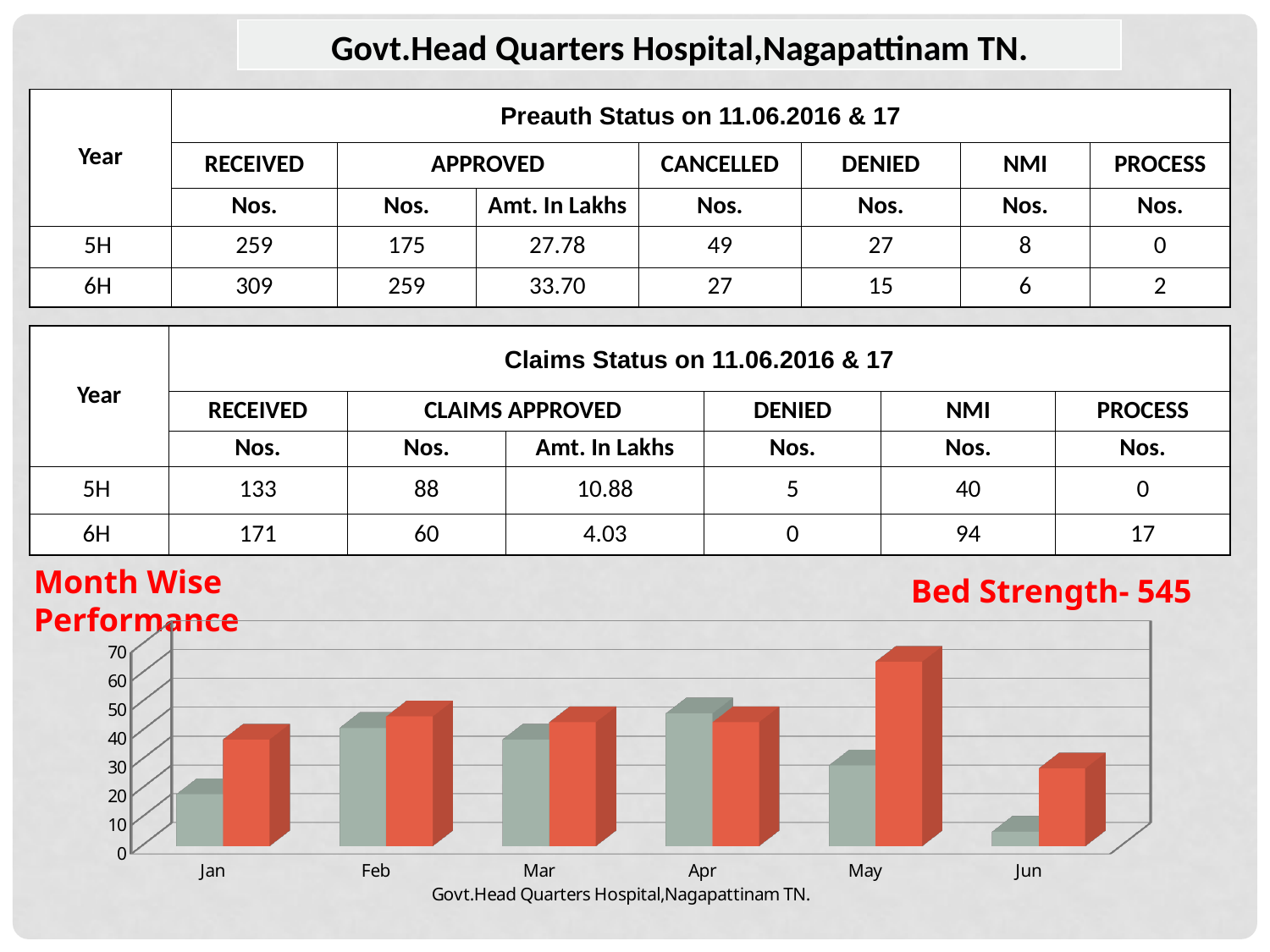
In the Month Wise Performance chart, is the red bar for May greater or less than 50? greater In the Month Wise Performance chart, is the grey bar for Jun greater or less than 10? less In the Month Wise Performance chart, which month has the tallest red bar? May What kind of chart is shown at the bottom of the slide? bar chart How many months are shown on the x axis of the Month Wise Performance chart? 6 In the Month Wise Performance chart, which month has the shortest grey bar? Jun In the Month Wise Performance chart, which is larger for Jan, the grey bar or the red bar? the red bar In the Month Wise Performance chart, is the red bar for Jan greater or less than 30? greater In the Month Wise Performance chart, which month has the shortest red bar? Jun In the Month Wise Performance chart, which is larger for May, the grey bar or the red bar? the red bar How many data series (bars per month) are plotted in the Month Wise Performance chart? 2 What text appears as the axis title below the months in the Month Wise Performance chart? Govt.Head Quarters Hospital,Nagapattinam TN.